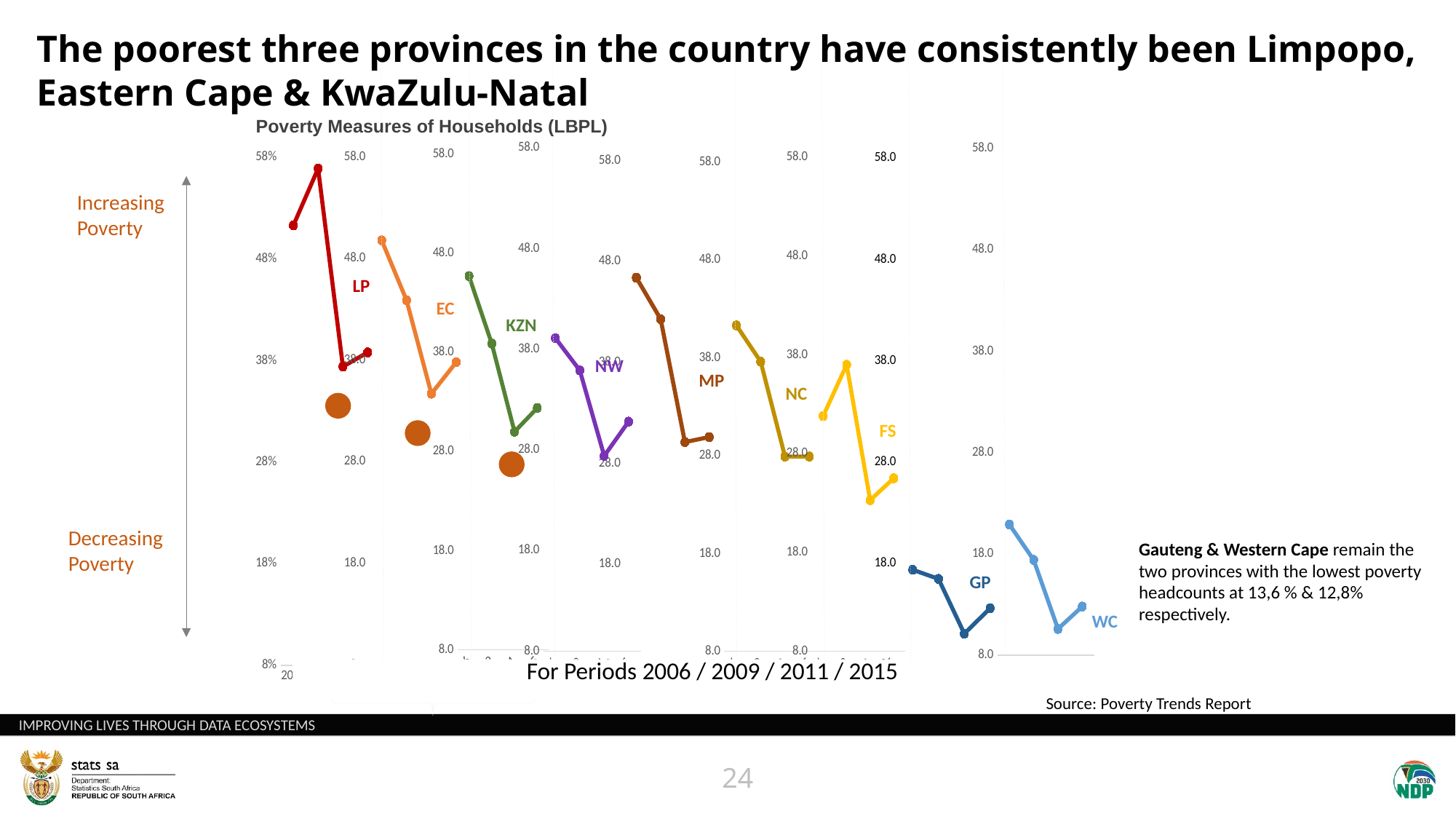
According to the slide text, what is Gauteng's poverty headcount? 13,6 % What is the title of the chart on this slide? Poverty Measures of Households (LBPL) What kind of chart is used to show the poverty measures of households on this slide? line chart Which province reaches the highest poverty value in the Poverty Measures of Households chart? LP How many data points does each province's line have in the Poverty Measures of Households chart? 4 Is the first point of the MP line greater or less than 38.0? greater How many provinces have their own line in the Poverty Measures of Households (LBPL) chart? 9 Which is higher, the peak of the LP line or the peak of the KZN line? LP Is the lowest point of the GP line greater or less than 18.0? less From the first period to the last period, does the EC line rise or fall overall? fall Is the highest point of the LP line greater or less than 48.0? greater